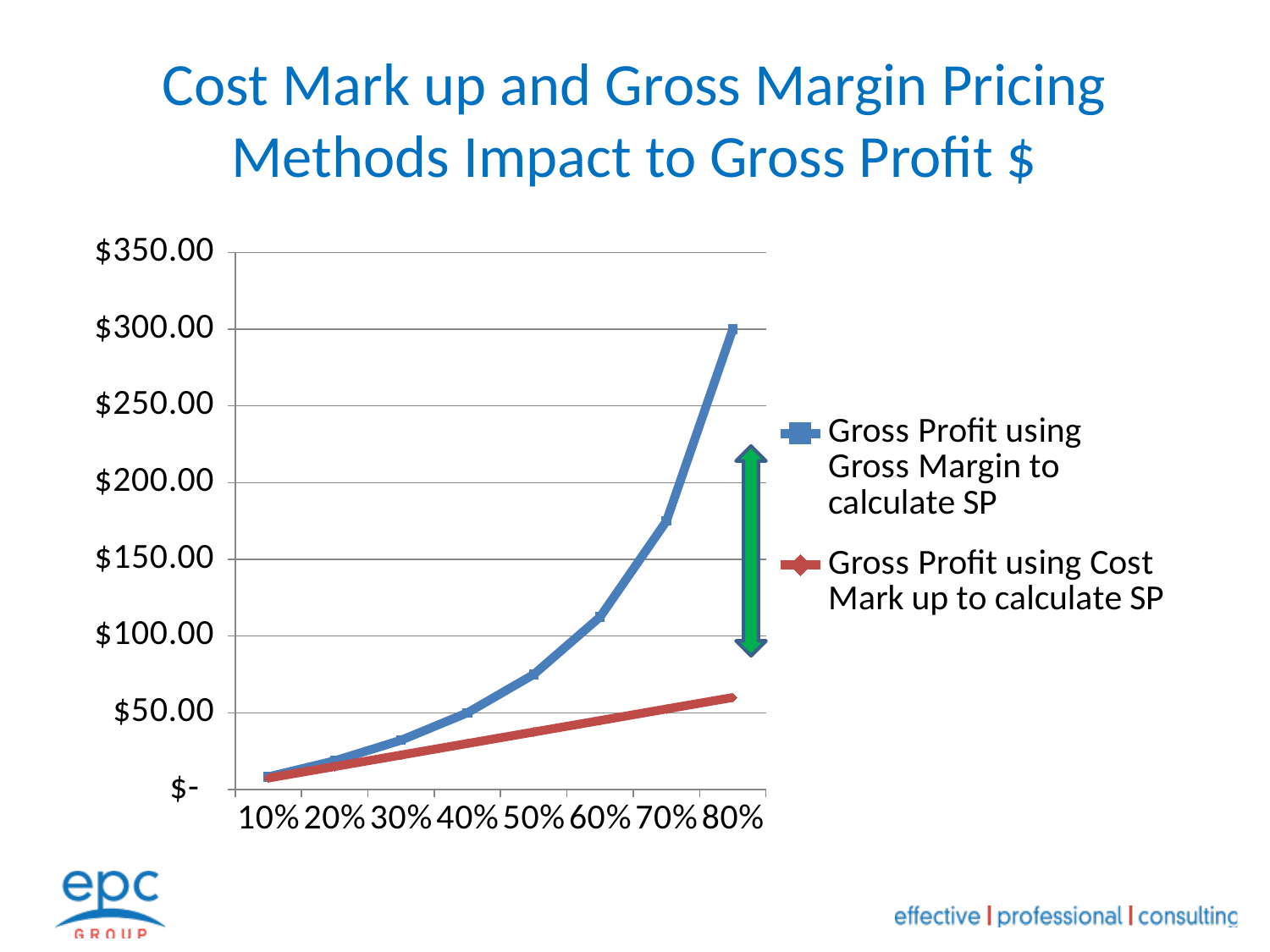
At which percentage is Gross Profit using Gross Margin to calculate SP highest? 80% How many series does the legend list? 2 What kind of chart is shown on the slide? line chart Is the value for Gross Profit using Cost Mark up to calculate SP at 50% greater or less than $50.00? less What is the title of the chart on the slide? Cost Mark up and Gross Margin Pricing Methods Impact to Gross Profit $ Do the values for Gross Profit using Gross Margin to calculate SP rise or fall as the percentage increases from 10% to 80%? rise Is the value for Gross Profit using Gross Margin to calculate SP at 70% greater or less than $150.00? greater At which percentage is Gross Profit using Cost Mark up to calculate SP lowest? 10% What is the value of Gross Profit using Gross Margin to calculate SP at 80%? $300.00 How many percentage categories are shown on the x axis? 8 Is the value for Gross Profit using Cost Mark up to calculate SP at 80% greater or less than $100.00? less At 80%, which series has the larger value: Gross Profit using Gross Margin to calculate SP or Gross Profit using Cost Mark up to calculate SP? Gross Profit using Gross Margin to calculate SP